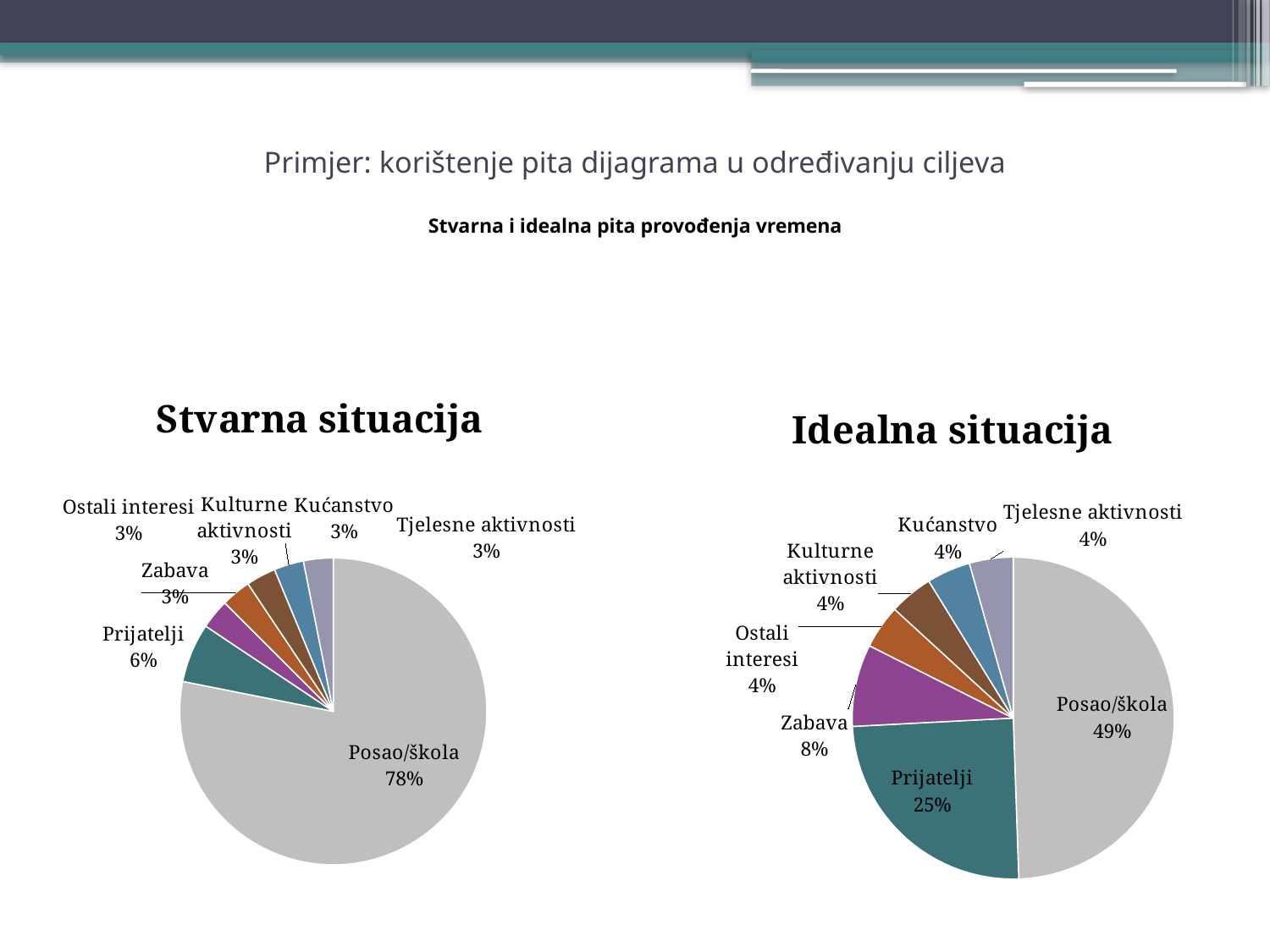
In the 'Idealna situacija' chart, what is the difference between Prijatelji and Zabava? 17% In the 'Idealna situacija' chart, what is the value for Zabava? 8% In the 'Stvarna situacija' chart, what is the value for Prijatelji? 6% How many slices does the 'Stvarna situacija' chart have? 7 In the 'Idealna situacija' chart, which category has the largest slice? Posao/škola What type of chart is 'Idealna situacija'? Pie chart What is the title of the chart on the left side of the slide? Stvarna situacija In the 'Stvarna situacija' chart, what share does Posao/škola have? 78% In the 'Stvarna situacija' chart, which category has the largest slice? Posao/škola In the 'Idealna situacija' chart, what share does Prijatelji have? 25% What is the difference between the Posao/škola share in the 'Stvarna situacija' chart and in the 'Idealna situacija' chart? 29% Which is larger: Prijatelji in the 'Stvarna situacija' chart or Prijatelji in the 'Idealna situacija' chart? Idealna situacija